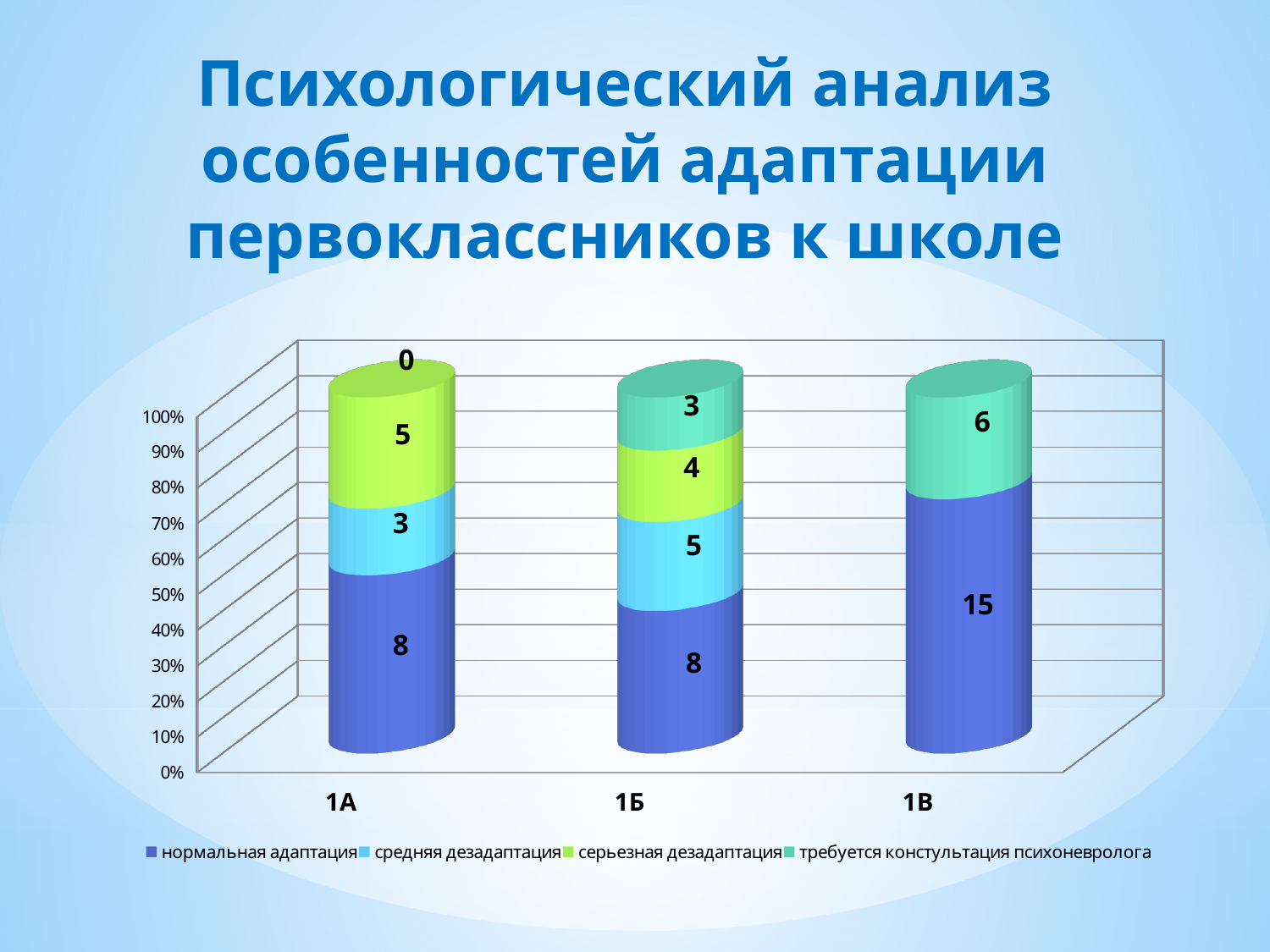
What is the value of требуется констультация психоневролога for class 1А? 0 How many series does the legend list? 4 What is the value of средняя дезадаптация for class 1Б? 5 Which class has the highest value for нормальная адаптация? 1В How many classes are shown on the x axis? 3 What is the difference between the нормальная адаптация values for 1В and 1А? 7 What is the sum of the labelled values in the bar for class 1Б? 20 What kind of chart is shown on the slide? Stacked bar chart What is the value of серьезная дезадаптация for class 1А? 5 What is the value of нормальная адаптация for class 1В? 15 Which class has the larger value for средняя дезадаптация, 1А or 1Б? 1Б Which class has the lowest value for требуется констультация психоневролога? 1А